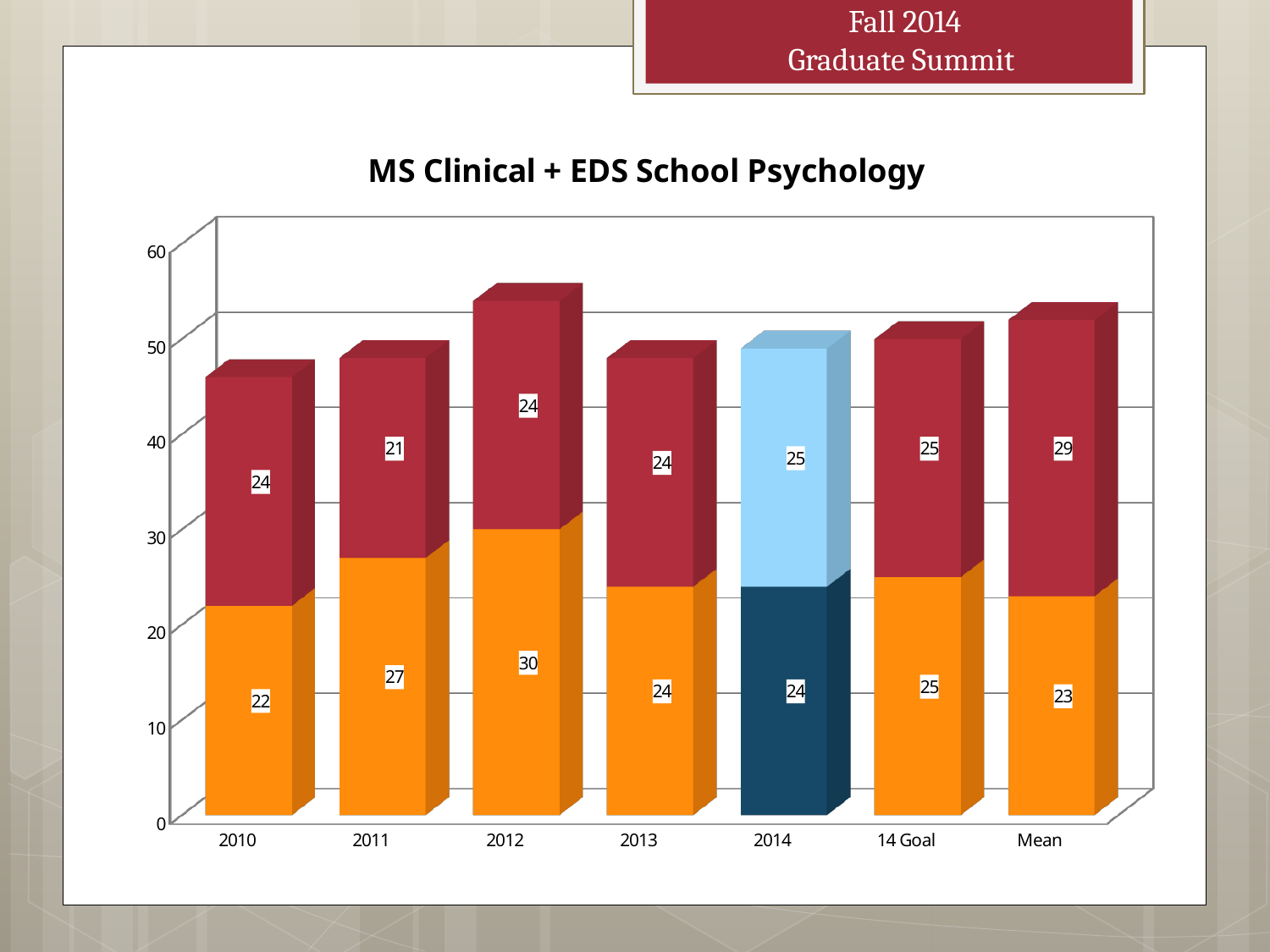
What kind of chart is shown on the slide? stacked bar chart What is the value of the bottom segment of the bar for 2010? 22 Which is larger, the top-segment value for Mean or the top-segment value for 14 Goal? Mean Which category has the lowest top-segment value? 2011 What is the title of the chart? MS Clinical + EDS School Psychology What is the total of the stacked bar for 2014? 49 What is the value of the bottom segment of the bar for 2012? 30 What is the value of the top segment of the bar for Mean? 29 What is the total of the stacked bar for 2012? 54 Which category has the highest bottom-segment value? 2012 How many categories are shown along the x axis of the chart? 7 What is the difference between the bottom-segment values for 2012 and 2010? 8